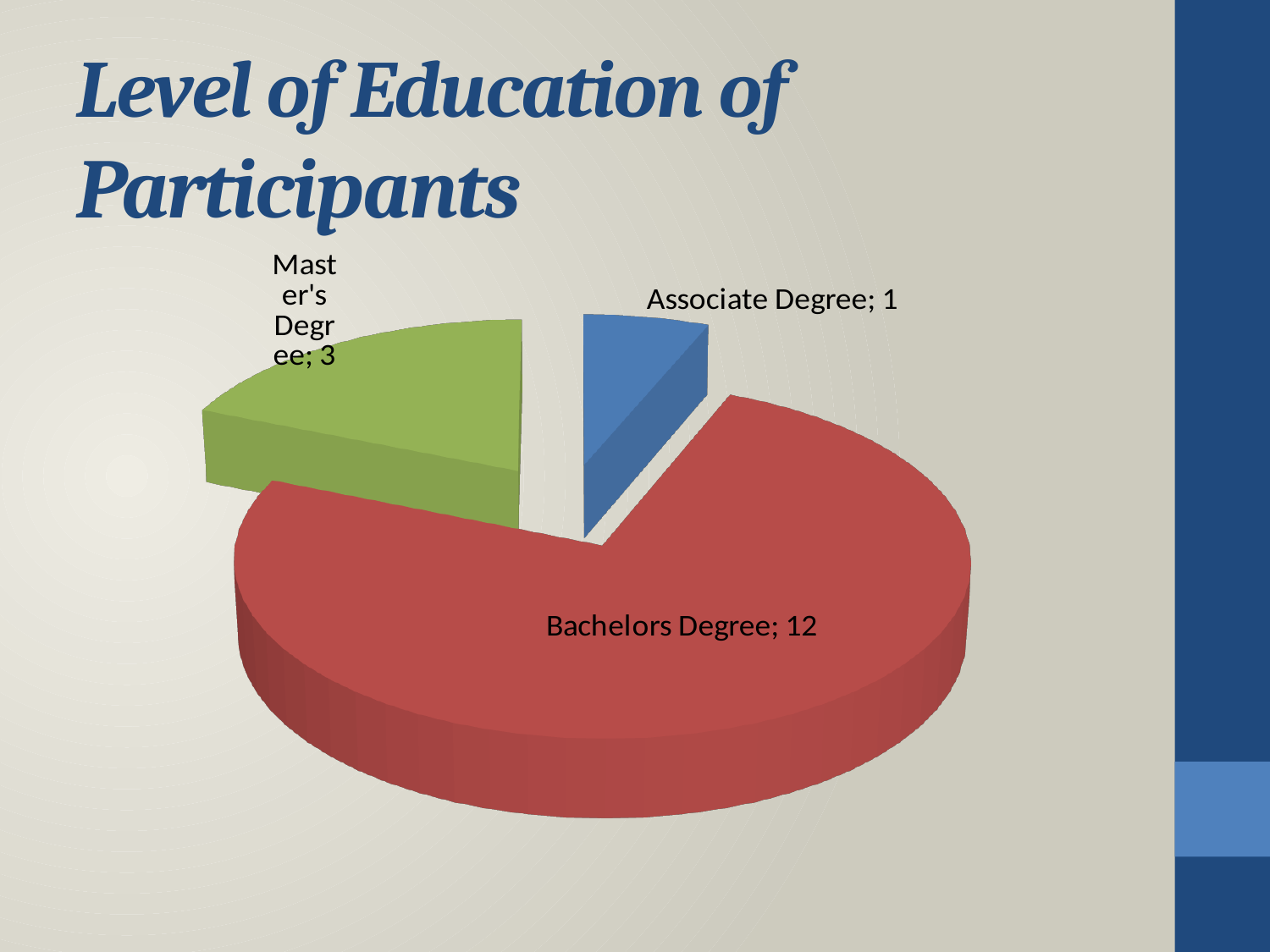
What is the total number of participants shown in the pie chart? 16 What kind of chart is shown on the slide? Pie chart Which level of education has the most participants? Bachelors Degree How many participants have a Bachelors Degree? 12 Which has more participants, Master's Degree or Associate Degree? Master's Degree Which level of education has the fewest participants? Associate Degree How many participants have a Master's Degree? 3 What is the difference between the number of participants with a Master's Degree and those with an Associate Degree? 2 What colour is the Bachelors Degree slice? Red How many education levels are shown in the pie chart? 3 How many participants have an Associate Degree? 1 What is the difference between the number of participants with a Bachelors Degree and those with a Master's Degree? 9